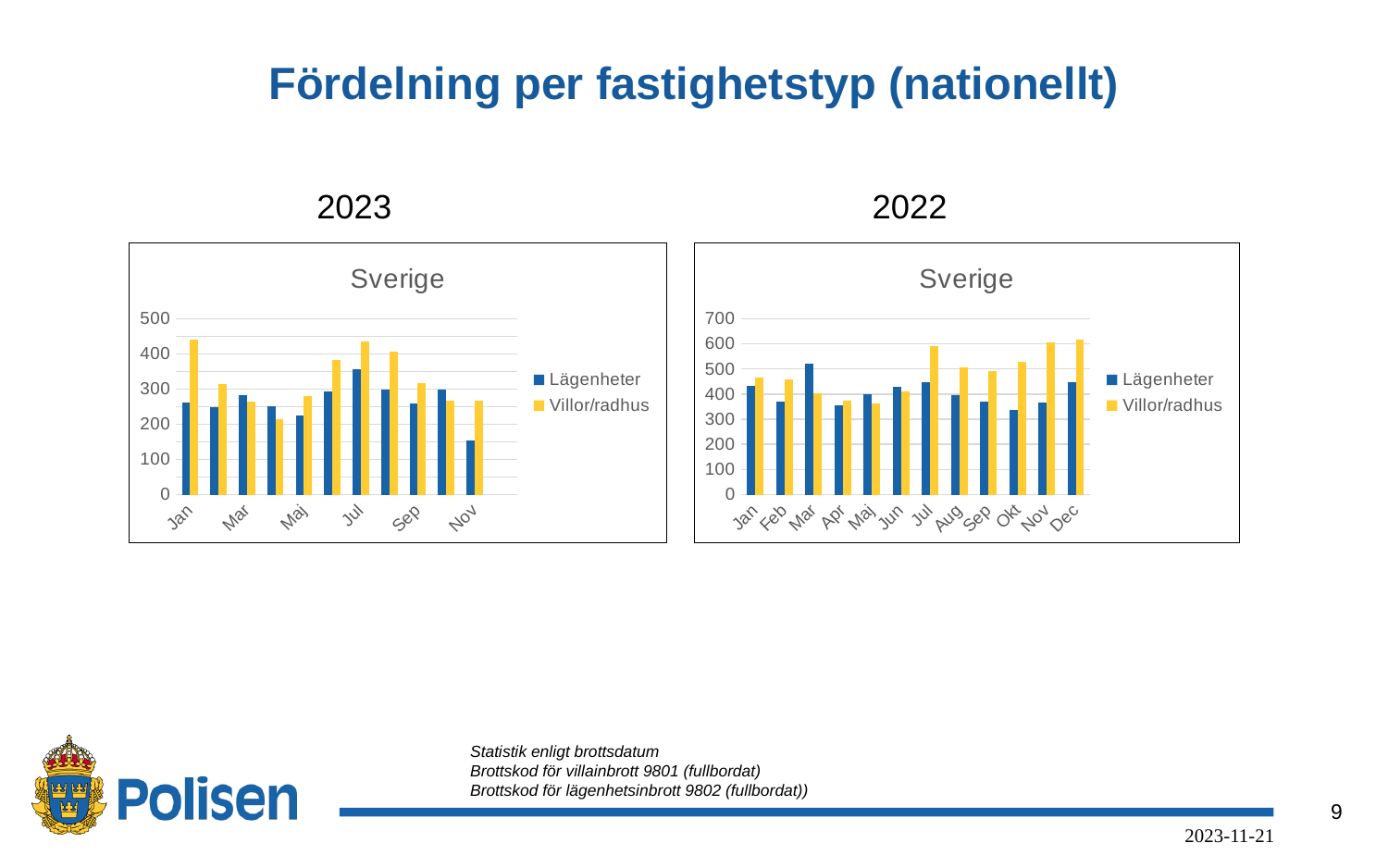
In the 2022 chart, which month has the highest Lägenheter value? Mar In the 2022 chart, which series has the larger value in Jul, Lägenheter or Villor/radhus? Villor/radhus In the 2022 chart, which series has the larger value in Okt, Lägenheter or Villor/radhus? Villor/radhus In the 2023 chart, which month has the lowest Lägenheter value? Nov In the 2023 chart, is the Lägenheter value for Nov greater or less than 200? less How many months are plotted in the 2023 chart? 11 In the 2023 chart, is the Villor/radhus value for Jan greater or less than 400? greater How many series does the legend of the 2022 chart list? 2 In the 2022 chart, is the Villor/radhus value for Nov greater or less than 500? greater What kind of chart is the 2023 chart on the left? bar chart What is the title shown inside both charts? Sverige How many months are plotted in the 2022 chart? 12